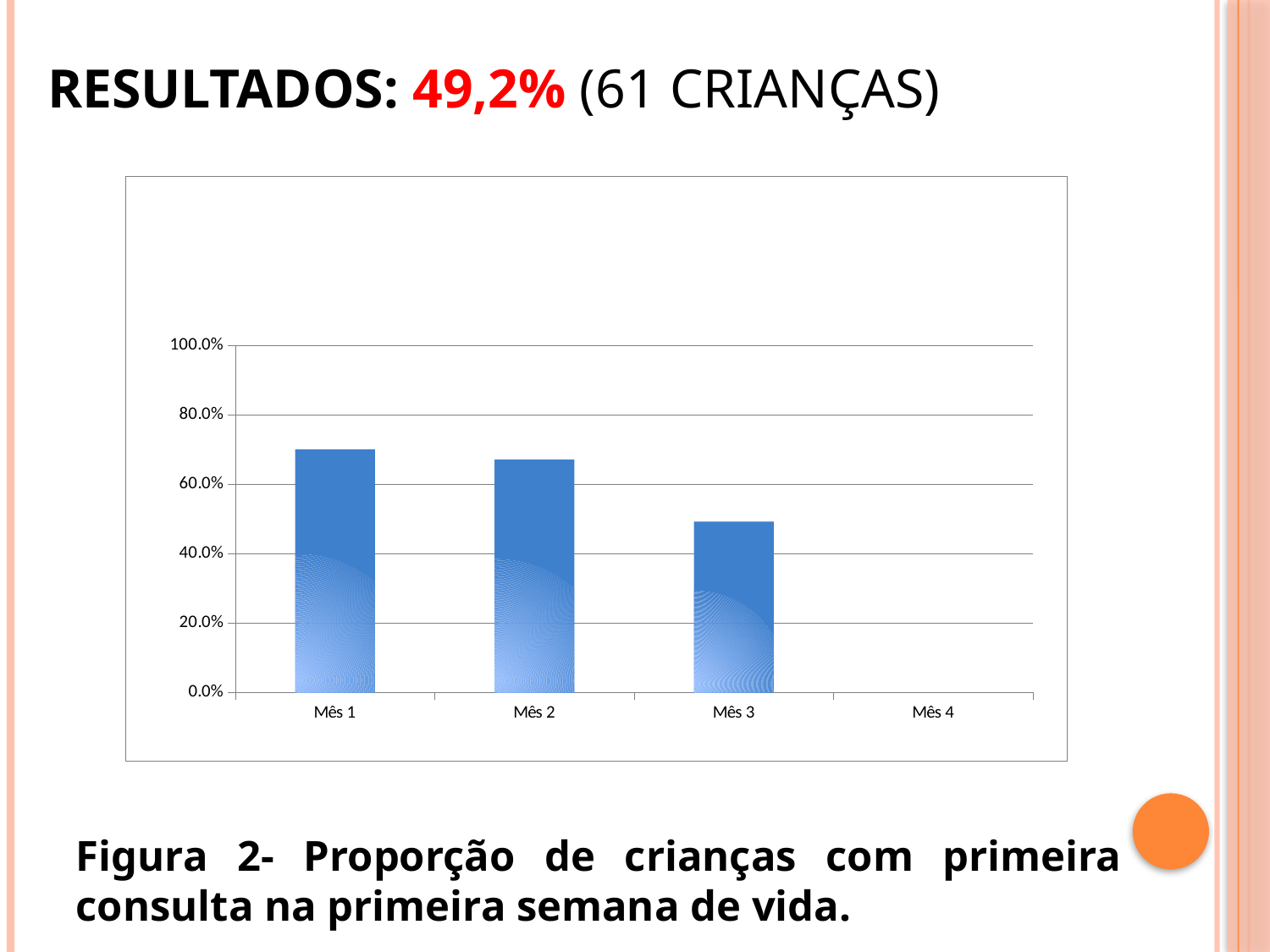
Among the categories with a visible bar, which has the lowest value? Mês 3 Is the value for Mês 2 greater or less than 60.0%? greater Is the value for Mês 1 greater or less than 60.0%? greater Which category has the highest bar in the chart? Mês 1 Is the value for Mês 3 greater or less than 60.0%? less Which is larger, the value for Mês 1 or the value for Mês 3? Mês 1 How many categories are shown on the x axis of the chart? 4 Do the bar values rise or fall from Mês 1 to Mês 3? fall What kind of chart is shown on the slide? bar chart What is the highest value labelled on the y axis of the chart? 100.0%